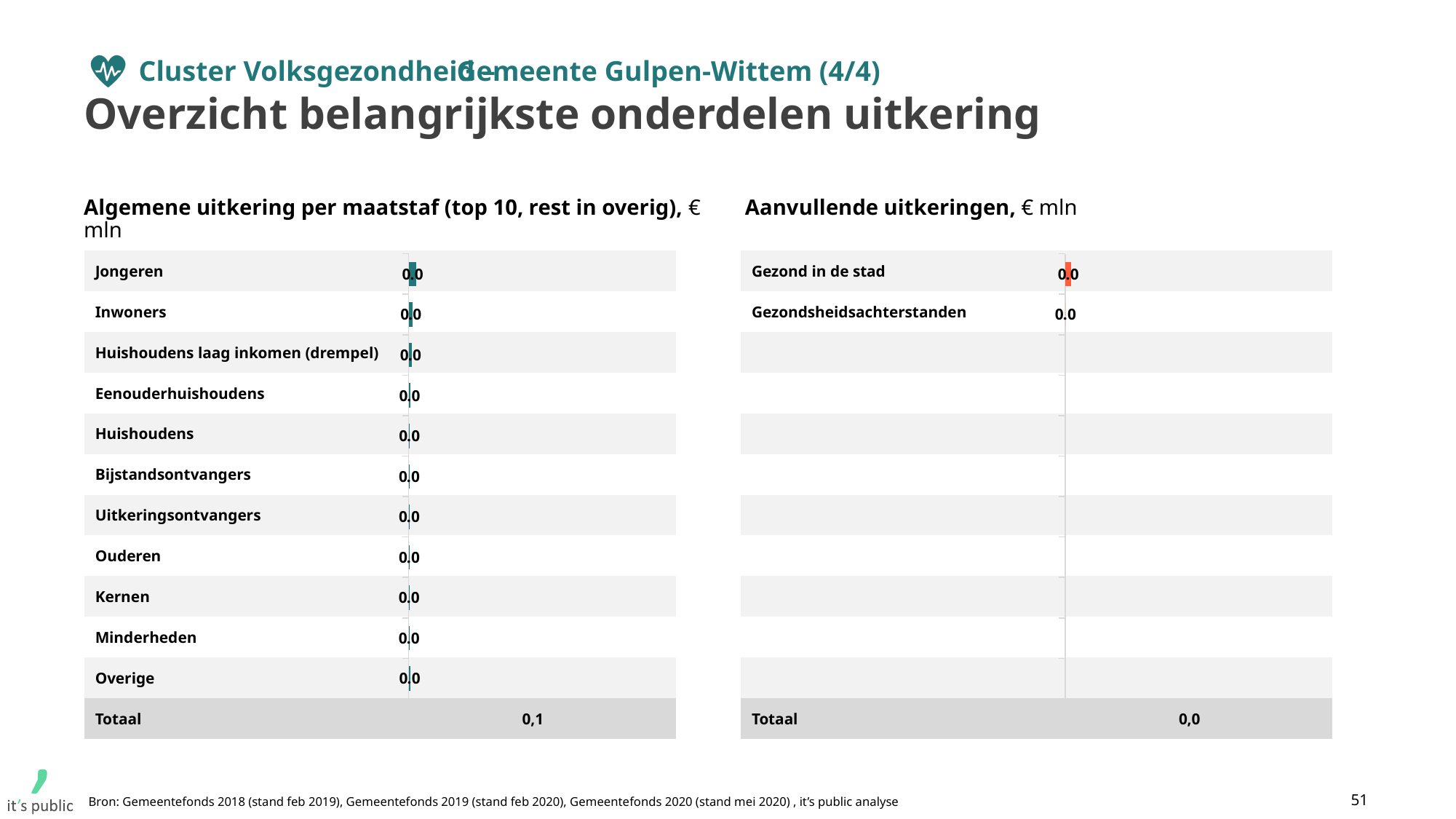
On the left chart (Algemene uitkering per maatstaf), what is the value shown for Overige? 0.0 How many categories (excluding the Totaal row) are listed on the right chart (Aanvullende uitkeringen)? 2 On the right chart (Aanvullende uitkeringen), what value is shown in the Totaal row? 0,0 On the left chart (Algemene uitkering per maatstaf), what value is shown in the Totaal row? 0,1 What colour is the bar for Gezond in de stad on the right chart (Aanvullende uitkeringen)? Orange-red How many categories (excluding the Totaal row) are listed on the left chart (Algemene uitkering per maatstaf)? 11 What kind of chart is the left chart (Algemene uitkering per maatstaf)? Bar chart On the right chart (Aanvullende uitkeringen), what is the value for Gezond in de stad? 0.0 What unit is stated in the title of the right chart (Aanvullende uitkeringen)? € mln On the left chart (Algemene uitkering per maatstaf), what is the value for Jongeren? 0.0 On the right chart (Aanvullende uitkeringen), what is the value for Gezondsheidsachterstanden? 0.0 On the left chart (Algemene uitkering per maatstaf), what is the value for Huishoudens laag inkomen (drempel)? 0.0